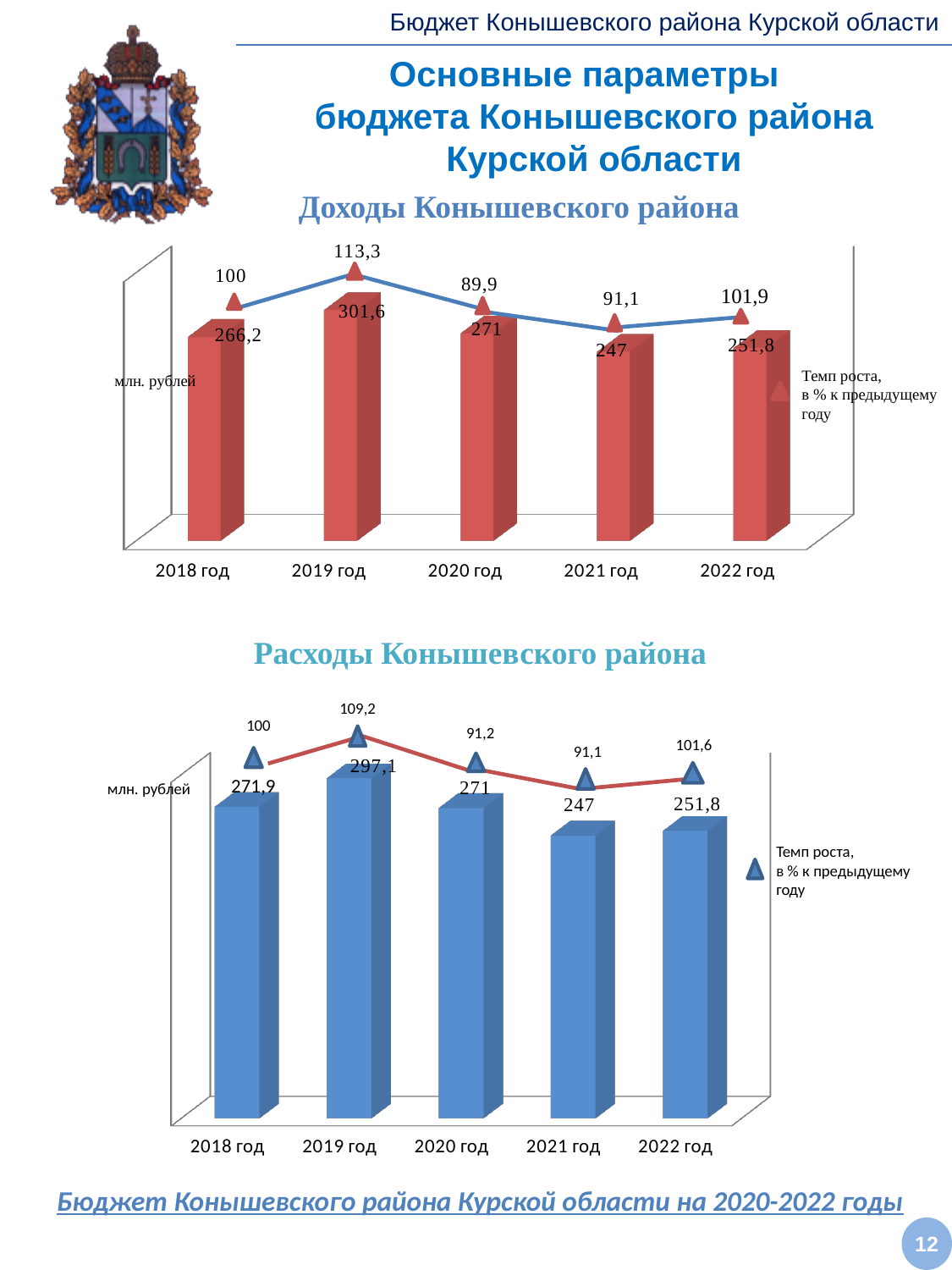
In the 'Доходы Конышевского района' chart, what is the difference between the 2019 год and 2018 год values in млн. рублей? 35,4 In the 'Расходы Конышевского района' chart, what is the growth rate (Темп роста) for 2019 год? 109,2 In the 'Доходы Конышевского района' chart, which year has the lowest value in млн. рублей? 2021 год In the 'Доходы Конышевского района' chart, which year has the highest value in млн. рублей? 2019 год How many years are shown on the x axis of the 'Расходы Конышевского района' chart? 5 In the 'Расходы Конышевского района' chart, is the value for 2020 год or 2021 год larger? 2020 год What type of chart is used for the млн. рублей values in the 'Расходы Конышевского района' chart? bar chart In the 'Расходы Конышевского района' chart, which year has the highest growth rate (Темп роста)? 2019 год In the 'Доходы Конышевского района' chart, do the bar values rise or fall from 2019 год to 2021 год? fall In the 'Доходы Конышевского района' chart, what is the value in млн. рублей for 2019 год? 301,6 In the 'Расходы Конышевского района' chart, what is the value in млн. рублей for 2018 год? 271,9 In the 'Доходы Конышевского района' chart, what is the growth rate (Темп роста) for 2020 год? 89,9